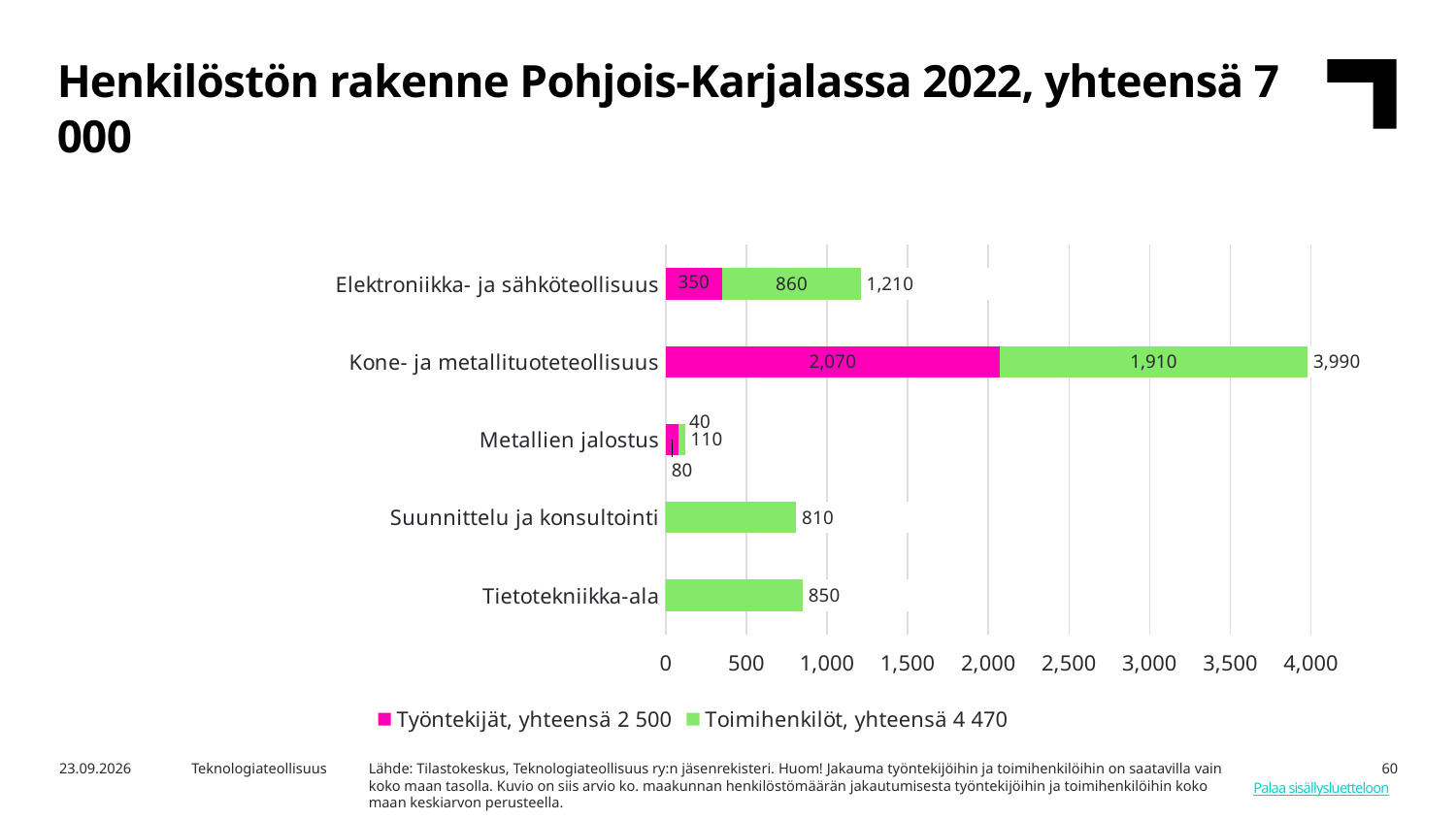
What is the Toimihenkilöt value for Elektroniikka- ja sähköteollisuus? 860 How many categories are shown on the chart? 5 How many series does the legend list? 2 Which category has the lowest total? Metallien jalostus What kind of chart is shown on the slide? Stacked bar chart What is the total for the Kone- ja metallituoteteollisuus bar? 3,990 What is the total for the Elektroniikka- ja sähköteollisuus bar? 1,210 What total is given for Toimihenkilöt in the legend? 4 470 Which is larger: the Työntekijät value or the Toimihenkilöt value for Kone- ja metallituoteteollisuus? Työntekijät Which category has the highest total? Kone- ja metallituoteteollisuus What is the Työntekijät value for Kone- ja metallituoteteollisuus? 2,070 What is the difference between the Tietotekniikka-ala value and the Suunnittelu ja konsultointi value? 40